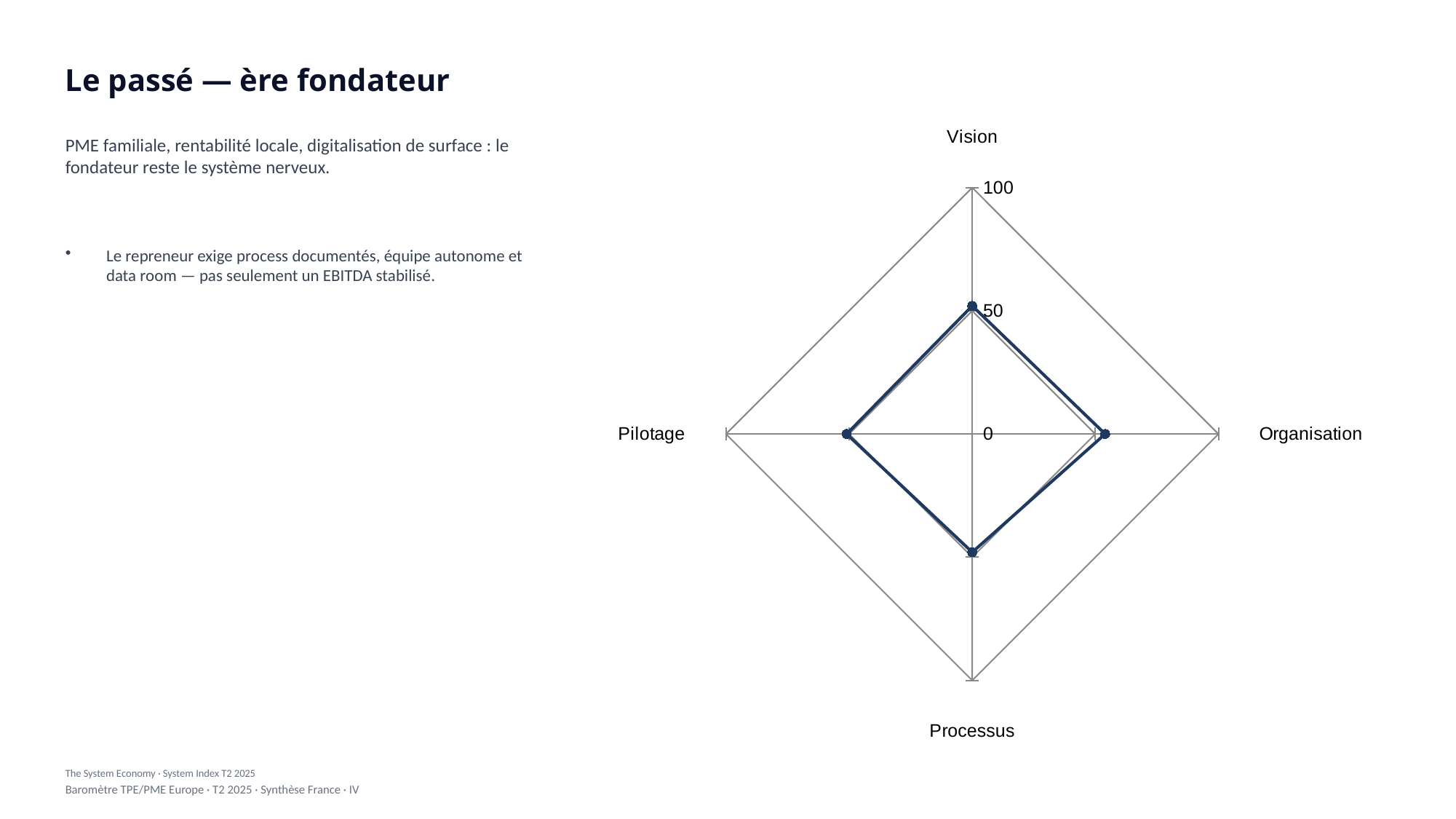
Is the value for Pilotage greater or less than 0? greater Is the value for Processus greater or less than 100? less What is the highest tick value shown on the radar chart's axis? 100 Is the value for Pilotage greater or less than 100? less Which category is placed at the top of the radar chart? Vision How many categories (axes) does the radar chart have? 4 What kind of chart is shown on the slide? radar chart